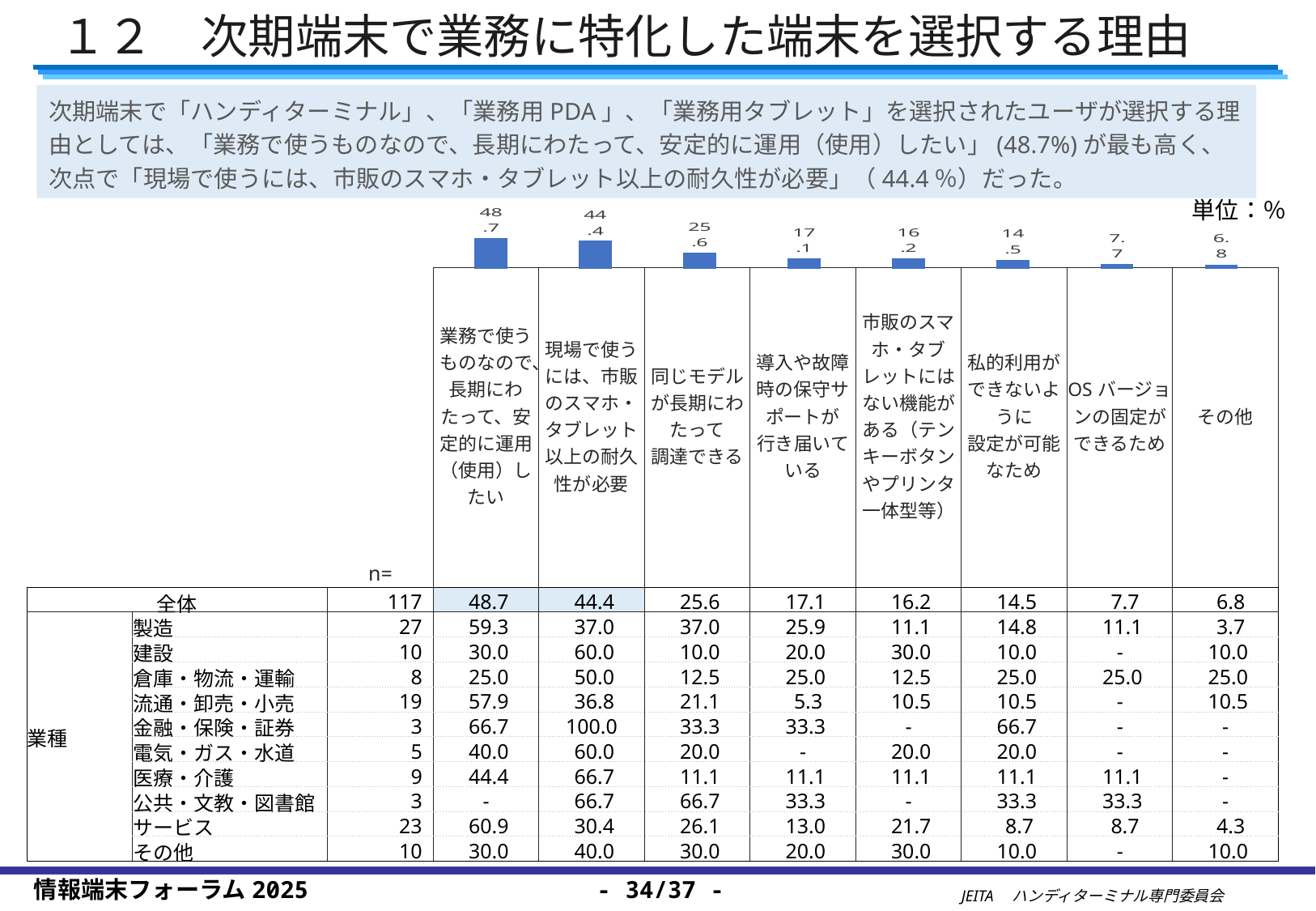
What is the value of the bar for 「現場で使うには、市販のスマホ・タブレット以上の耐久性が必要」? 44.4 What is the value of the bar for 「同じモデルが長期にわたって調達できる」? 25.6 How many bars does the chart above the table have? 8 What unit is indicated for the chart values on the slide? % Which category has the highest bar in the chart? 業務で使うものなので、長期にわたって、安定的に運用（使用）したい Which category has the lowest bar in the chart? その他 Do the bar values rise or fall from left to right across the chart? fall What is the value of the bar for 「OSバージョンの固定ができるため」? 7.7 What is the difference between the bar for 「業務で使うものなので、長期にわたって、安定的に運用（使用）したい」 and the bar for 「現場で使うには、市販のスマホ・タブレット以上の耐久性が必要」? 4.3 Which is larger: the bar for 「導入や故障時の保守サポートが行き届いている」 or the bar for 「私的利用ができないように設定が可能なため」? 導入や故障時の保守サポートが行き届いている What kind of chart is shown above the table on the slide? bar chart What is the value of the bar for 「業務で使うものなので、長期にわたって、安定的に運用（使用）したい」? 48.7